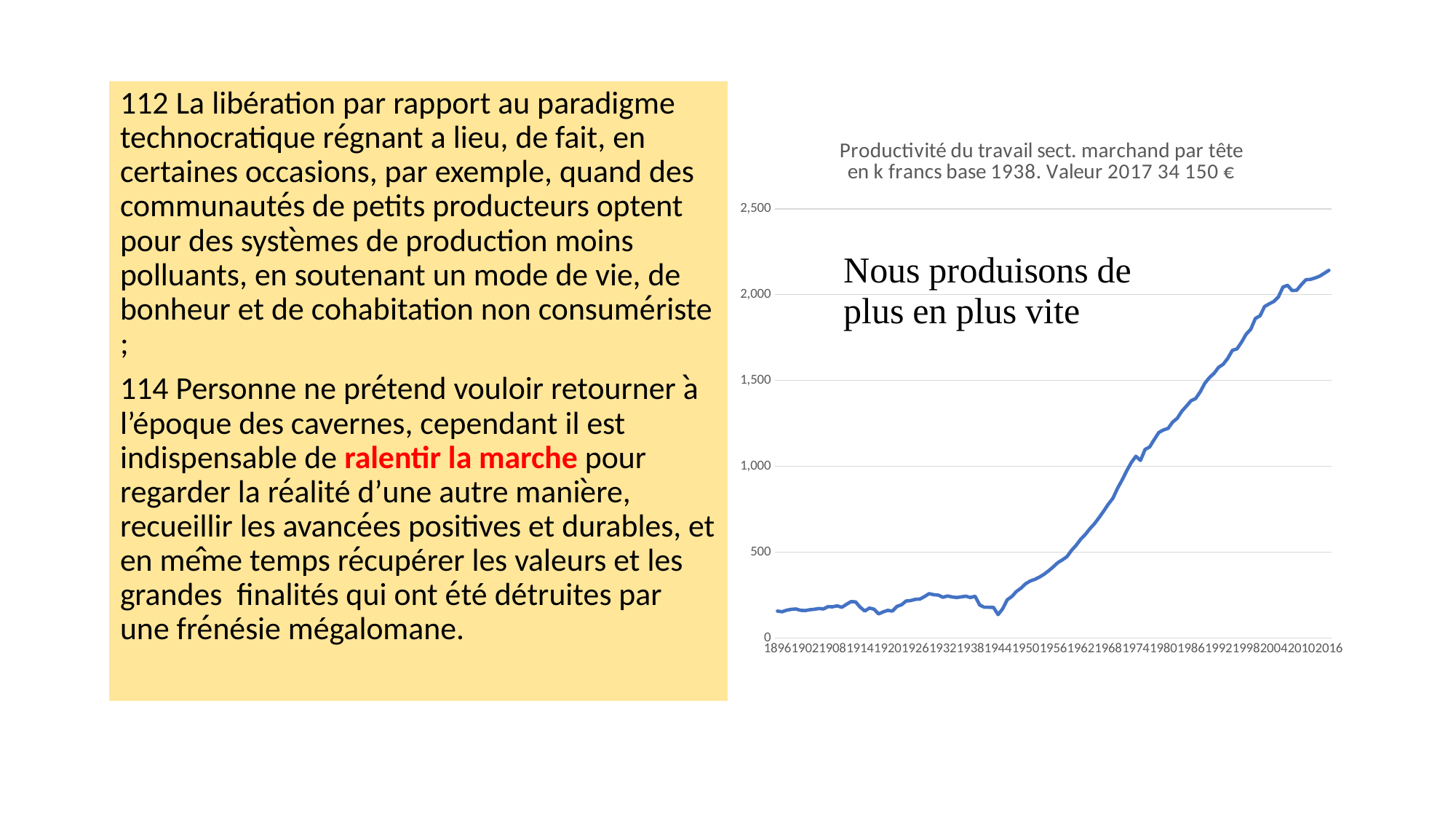
Is the value for 2016 greater or less than 2,000? greater Is the value for 1944 greater or less than 500? less Is the value for 1980 greater or less than 1,000? greater What text annotation is written over the chart area? Nous produisons de plus en plus vite Which year has the higher value, 1896 or 2016? 2016 What kind of chart is shown on the slide? line chart Overall, do the values in the chart rise or fall from 1896 to 2016? rise What is the title of the chart? Productivité du travail sect. marchand par tête en k francs base 1938. Valeur 2017 34 150 € In which year does the line reach its highest value? 2016 Which year has the higher value, 1938 or 1974? 1974